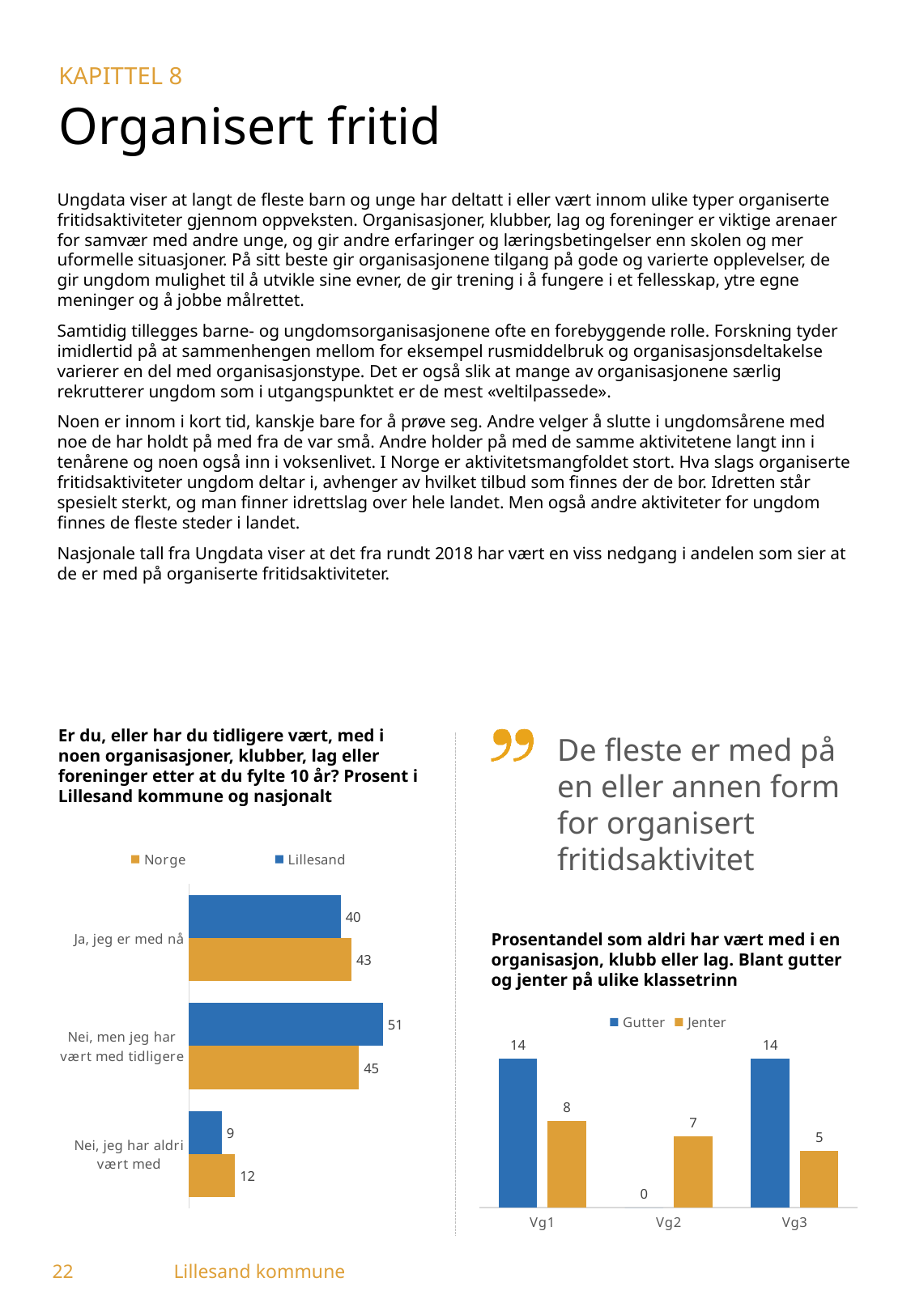
In the left chart, which is larger for 'Ja, jeg er med nå': Norge or Lillesand? Norge In the right chart, how many class levels are shown on the x axis? 3 In the left chart, what is the difference between the Norge and Lillesand values for 'Nei, jeg har aldri vært med'? 3 In the left chart, what is the Norge value for 'Ja, jeg er med nå'? 43 In the left chart, which category has the highest Lillesand value? Nei, men jeg har vært med tidligere In the right chart (Prosentandel som aldri har vært med i en organisasjon...), what is the value for Jenter in Vg2? 7 In the left chart (Er du, eller har du tidligere vært, med i noen organisasjoner...), what is the Lillesand value for 'Nei, men jeg har vært med tidligere'? 51 What kind of chart is the right chart? Bar chart In the right chart, which class level has the lowest Jenter value? Vg3 In the left chart, how many series does the legend list? 2 In the right chart, what is the value for Gutter in Vg2? 0 In the right chart, what is the difference between Gutter and Jenter in Vg3? 9